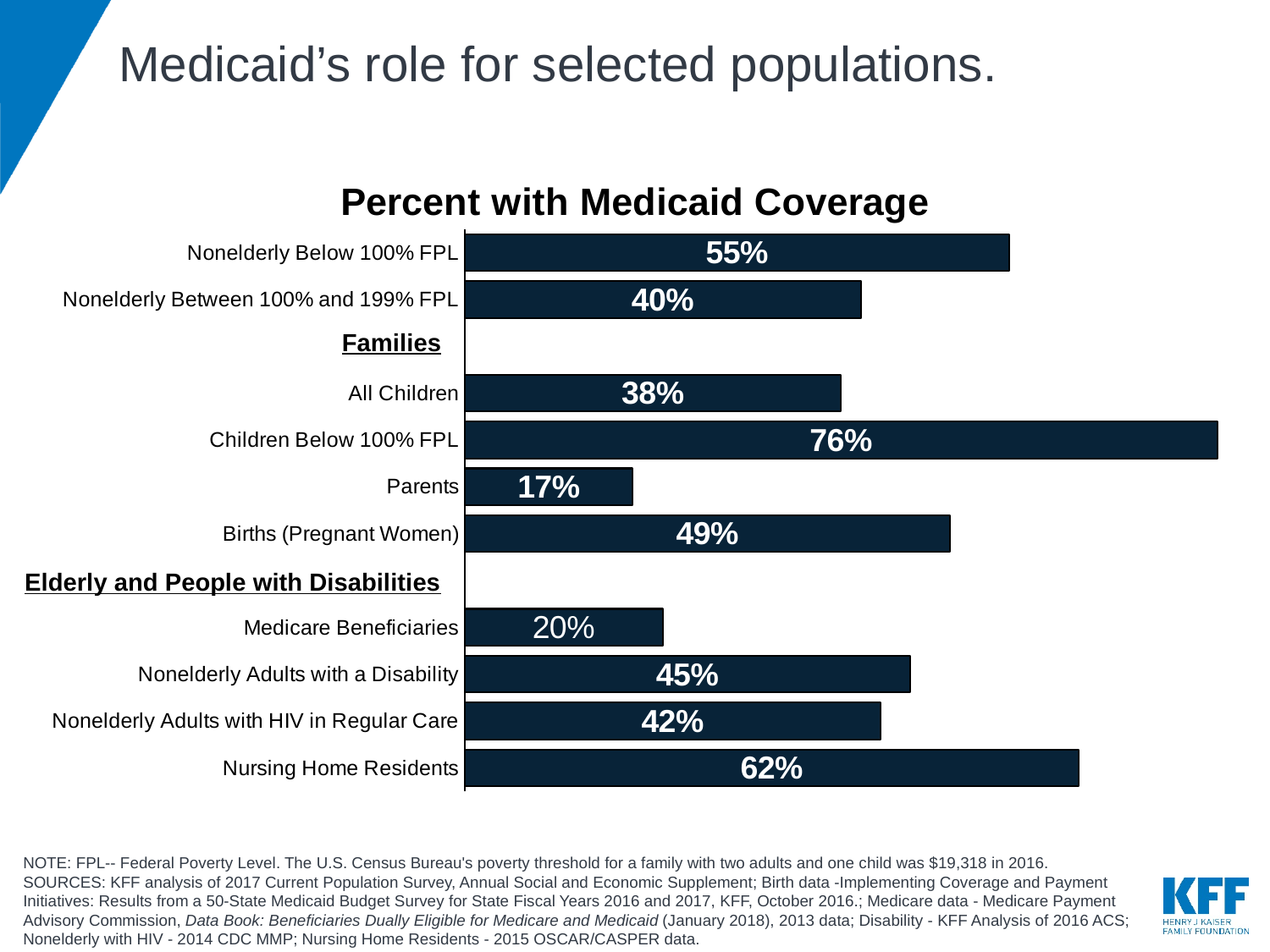
What is the difference between the values for Children Below 100% FPL and All Children? 38% How many bars with data values are plotted in the chart? 10 What percent of Children Below 100% FPL have Medicaid coverage? 76% What kind of chart is shown on the slide? Bar chart Which is larger: the value for Nonelderly Adults with a Disability or the value for Nonelderly Adults with HIV in Regular Care? Nonelderly Adults with a Disability Which category has the lowest percent with Medicaid coverage? Parents What is the title of the chart? Percent with Medicaid Coverage What is the value for Medicare Beneficiaries? 20% What percent of Parents have Medicaid coverage according to the chart? 17% Which category has the highest percent with Medicaid coverage? Children Below 100% FPL What is the value shown for Nursing Home Residents? 62% What is the difference between the values for Nonelderly Below 100% FPL and Nonelderly Between 100% and 199% FPL? 15%